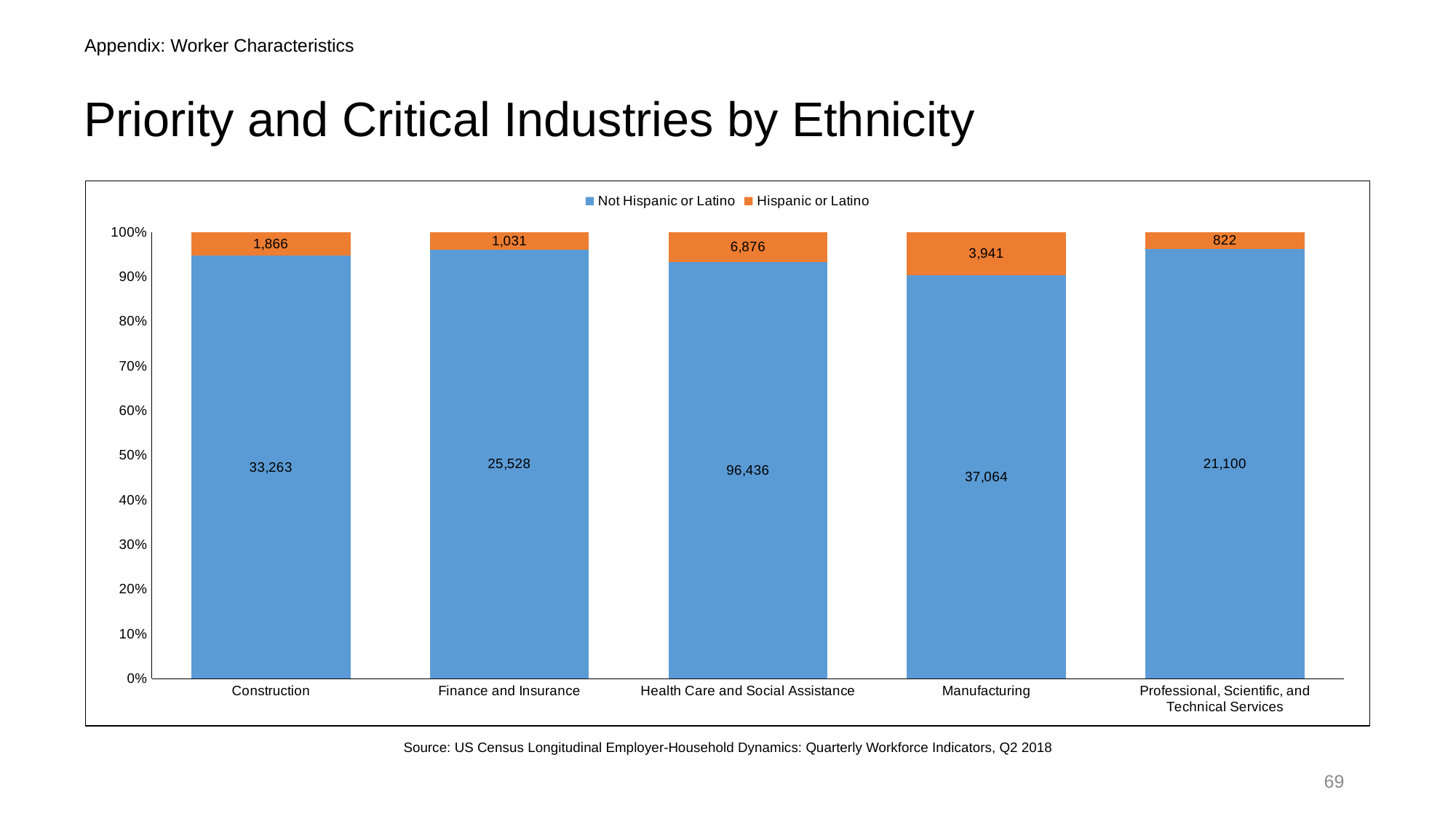
How many series does the legend list? 2 What is the value for Not Hispanic or Latino in Health Care and Social Assistance? 96,436 Which industry has the lowest Not Hispanic or Latino value? Professional, Scientific, and Technical Services Which is larger, the Hispanic or Latino value for Construction or for Finance and Insurance? Construction Is the Not Hispanic or Latino share of the Construction bar greater or less than 90%? greater How many industries are shown on the x axis? 5 What kind of chart is shown on the slide? Stacked bar chart What is the value for Not Hispanic or Latino in Professional, Scientific, and Technical Services? 21,100 What is the total of the two labelled values in the Finance and Insurance bar? 26,559 What is the value for Hispanic or Latino in Manufacturing? 3,941 What is the difference between the Not Hispanic or Latino values for Manufacturing and Construction? 3,801 Which industry has the highest Hispanic or Latino value? Health Care and Social Assistance